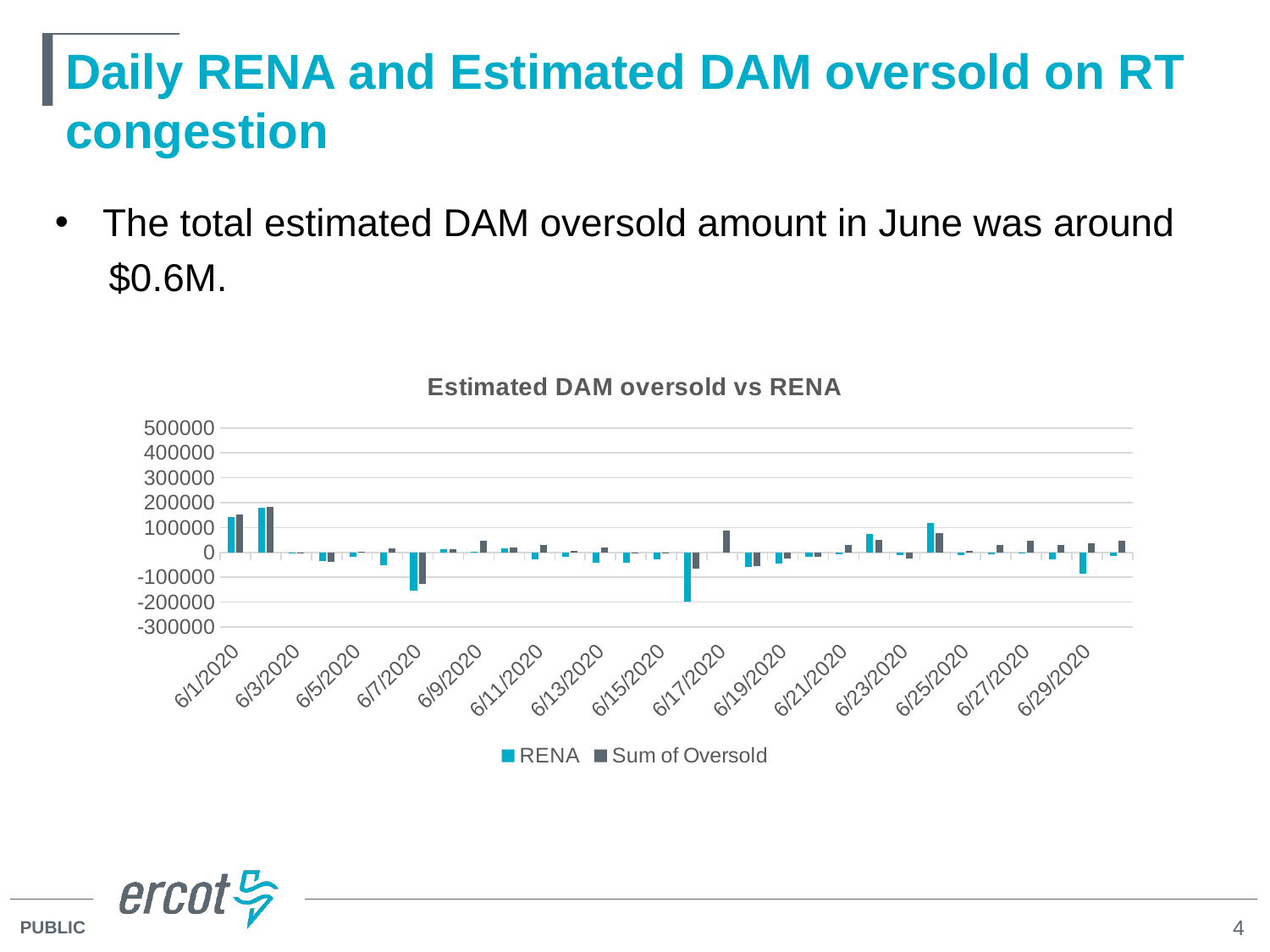
Is the Sum of Oversold value on 6/7/2020 greater or less than 0? less How many series does the chart legend list? 2 On which date does the RENA series reach its highest value? 6/2/2020 What is the title of the chart? Estimated DAM oversold vs RENA Is the Sum of Oversold value on 6/2/2020 greater or less than 100000? greater How many date labels are shown along the x axis of the chart? 15 Is the RENA value on 6/16/2020 greater or less than -100000? less What type of chart is shown on the slide? bar chart Which is larger: the RENA value on 6/2/2020 or the RENA value on 6/16/2020? 6/2/2020 On which date does the RENA series reach its lowest (most negative) value? 6/16/2020 Which series is shown in cyan (light blue) in the chart? RENA